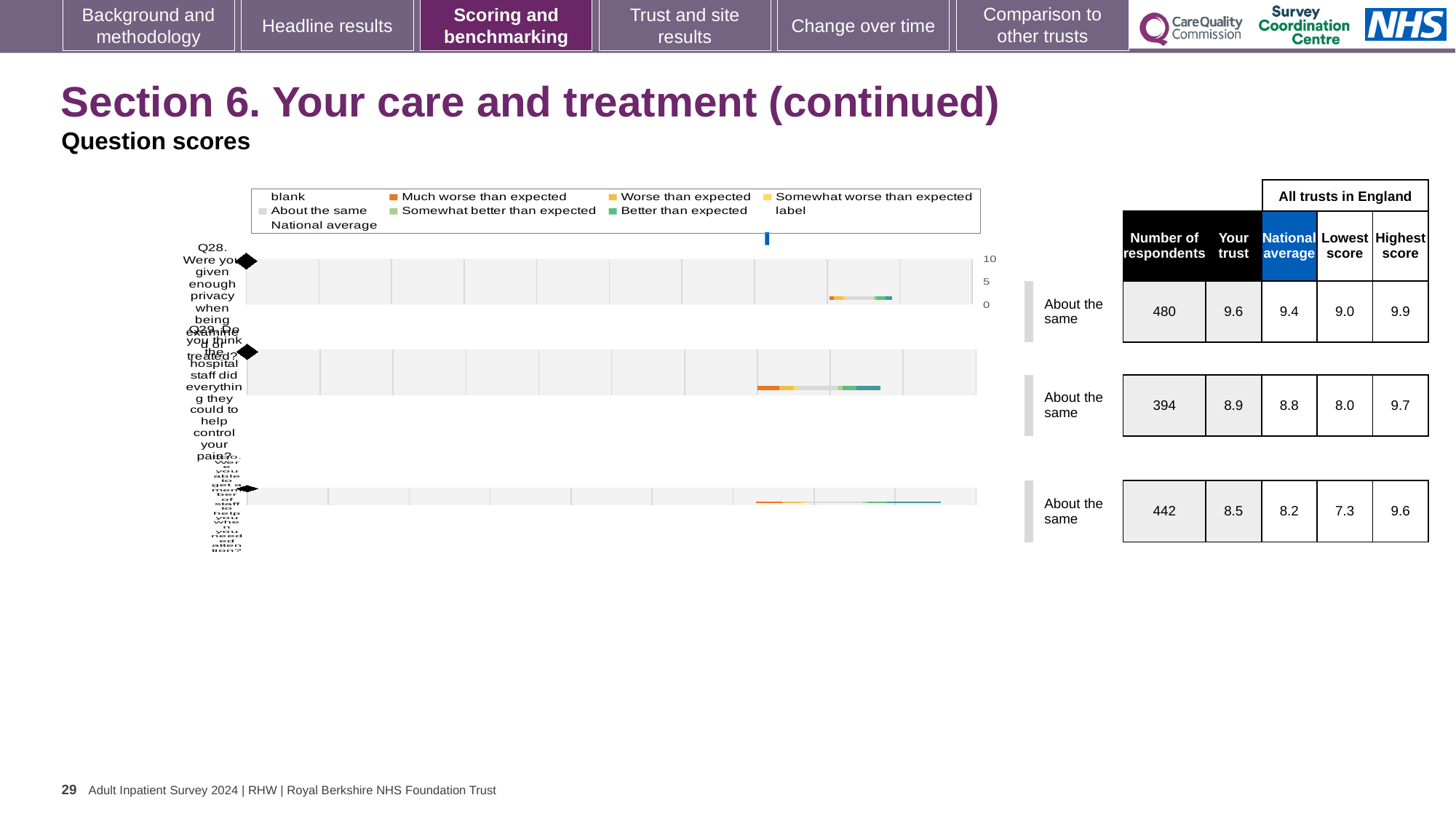
Which question has the lowest 'Lowest score' across all trusts in England? Q30 For Q29, which is larger: the trust's score or the national average? Your trust (8.9) What benchmark category is shown for Q30? About the same Which question has the highest 'Your trust' score? Q28 What is the highest score among all trusts in England for Q28? 9.9 How many more respondents answered Q28 than Q29? 86 How many respondents answered Q30? 442 How many questions are plotted on the chart? 3 Is the trust's score for Q30 greater or less than 5? greater What is the national average score for Q29 (staff did everything to help control pain)? 8.8 By how much does the trust's score for Q28 exceed the national average? 0.2 What is the 'Your trust' score for Q28 (privacy when being examined or treated)? 9.6